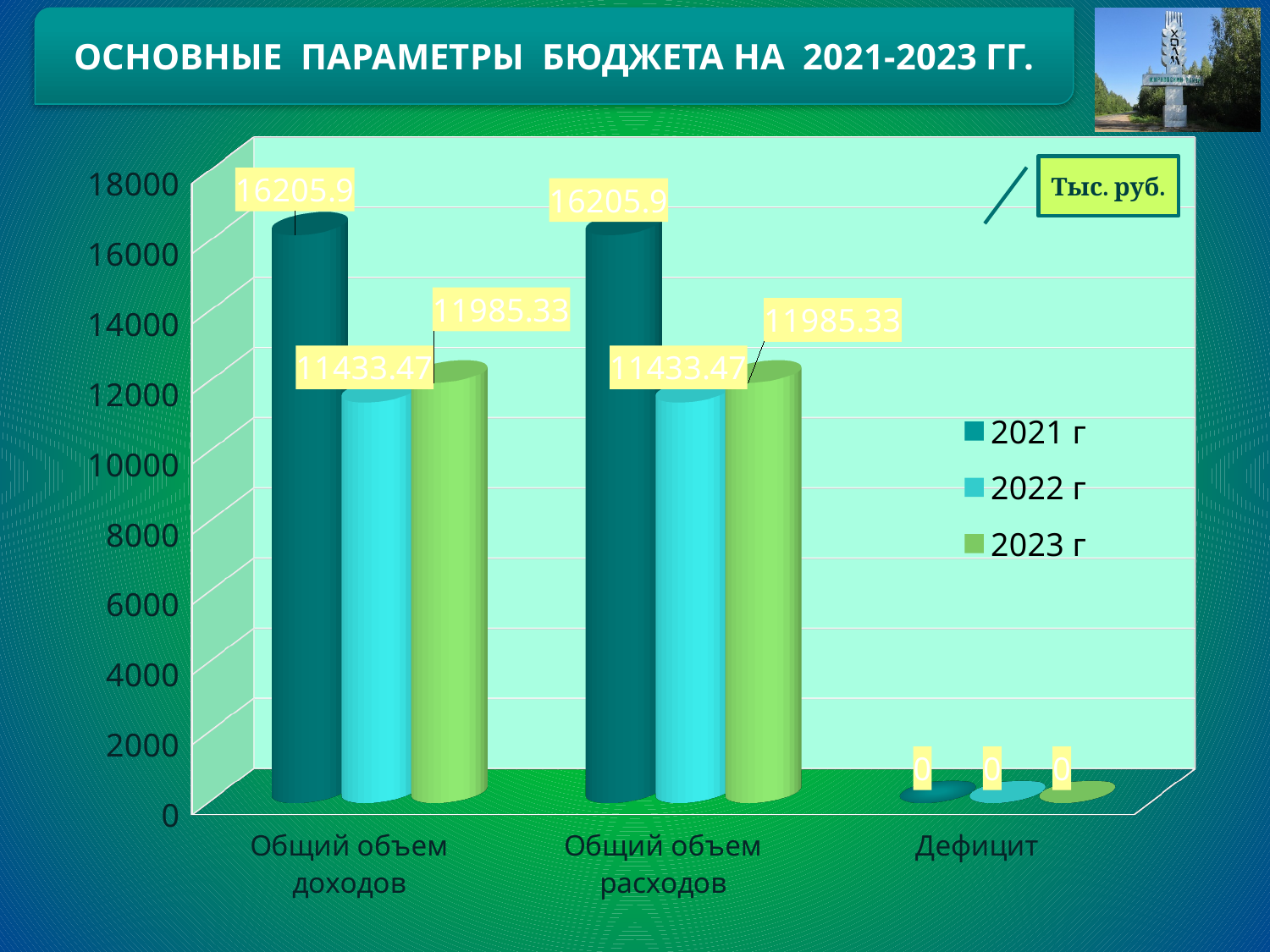
What kind of chart is shown on the slide? Bar chart How many series does the legend list? 3 What is the value for 2023 г in the Общий объем доходов category? 11985.33 Which year has the highest value in the Общий объем расходов category? 2021 г Which year has the lowest value in the Общий объем доходов category? 2022 г What unit is indicated in the box at the top right of the chart? Тыс. руб. What is the value for 2021 г in the Дефицит category? 0 What is the difference between the 2021 г and 2022 г values in the Общий объем доходов category? 4772.43 Which is larger in the Общий объем расходов category: the 2022 г value or the 2023 г value? 2023 г How many categories are shown on the x axis? 3 What is the value for 2021 г in the Общий объем доходов category? 16205.9 What is the value for 2022 г in the Общий объем расходов category? 11433.47